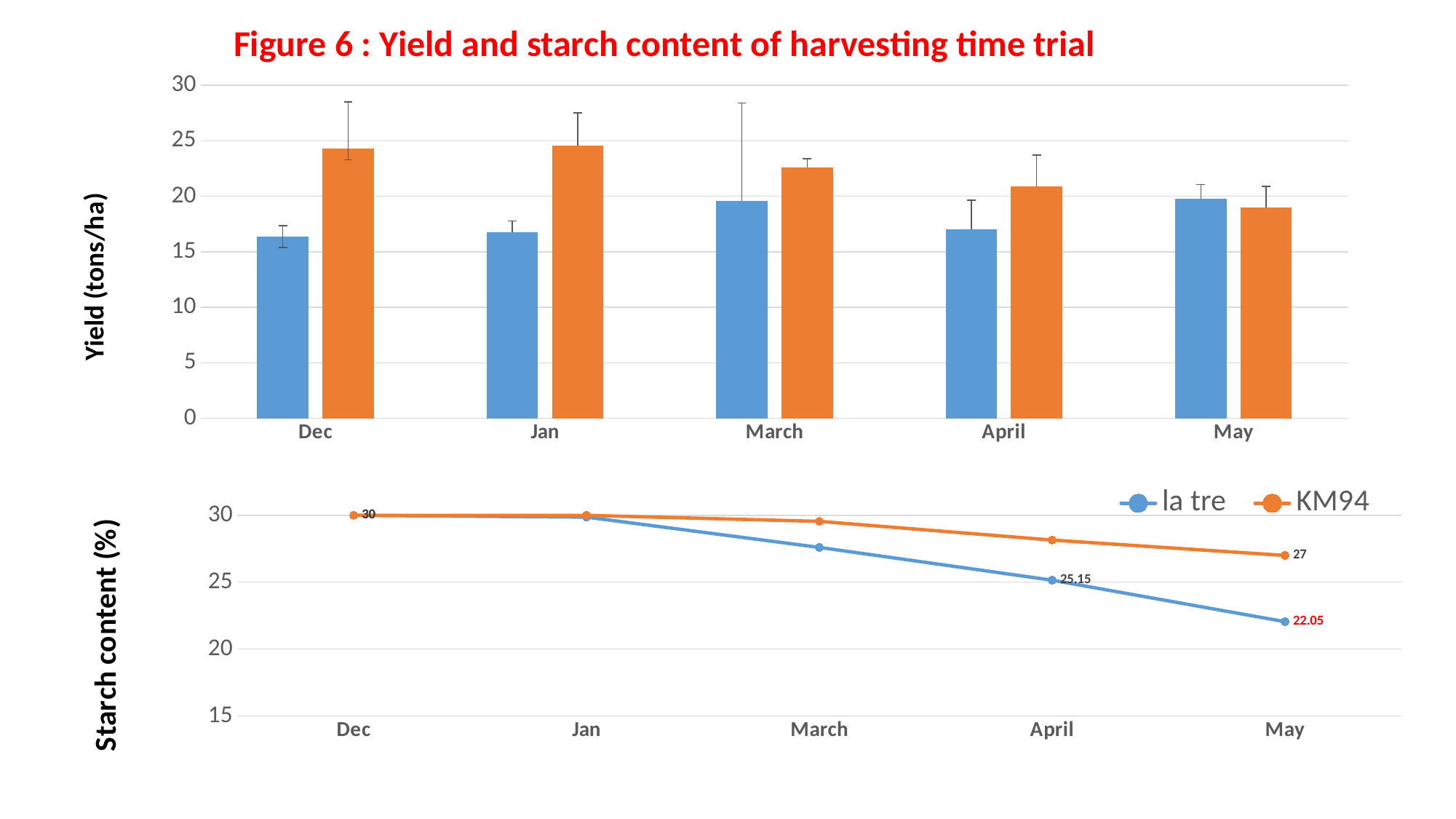
In the top yield chart, which series has the higher yield in Dec, la tre or KM94? KM94 In the top yield chart, is the yield of KM94 in Dec greater or less than 20? greater What type of chart is the top chart showing yield? bar chart In the bottom starch content chart, what is the starch content of la tre in April? 25.15 In the bottom starch content chart, does the starch content of la tre rise or fall from Jan to May? fall In the bottom starch content chart, what is the difference between KM94 and la tre in May? 4.95 What type of chart is the bottom chart showing starch content? line chart In the top yield chart, is the yield of la tre in Jan greater or less than 20? less In the bottom starch content chart, what is the starch content of KM94 in May? 27 In the bottom starch content chart, what is the starch content of la tre in May? 22.05 In the top yield chart, how many harvest months are shown on the x axis? 5 How many series does the legend list? 2